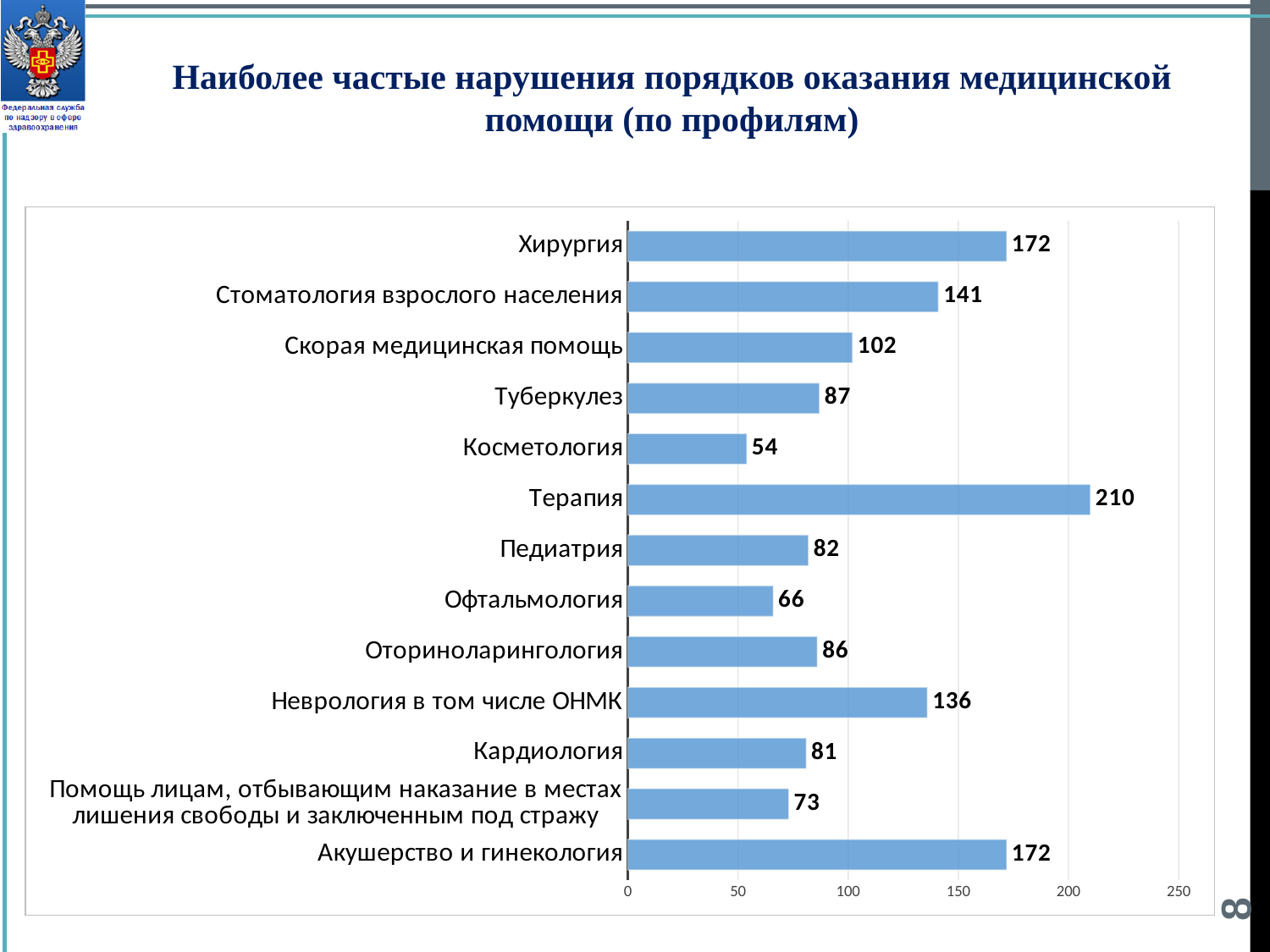
What is the value for Помощь лицам, отбывающим наказание в местах лишения свободы и заключенным под стражу? 73 How many categories are shown in the chart? 13 What is the value for Терапия? 210 Is the value for Скорая медицинская помощь greater or less than 100? greater Which is larger, the value for Туберкулез or the value for Педиатрия? Туберкулез What is the value for Неврология в том числе ОНМК? 136 Which category has the lowest value? Косметология What kind of chart is shown on the slide? bar chart Which category has the highest value? Терапия What is the title of the slide? Наиболее частые нарушения порядков оказания медицинской помощи (по профилям) What is the value for Стоматология взрослого населения? 141 What is the difference between the values for Терапия and Хирургия? 38